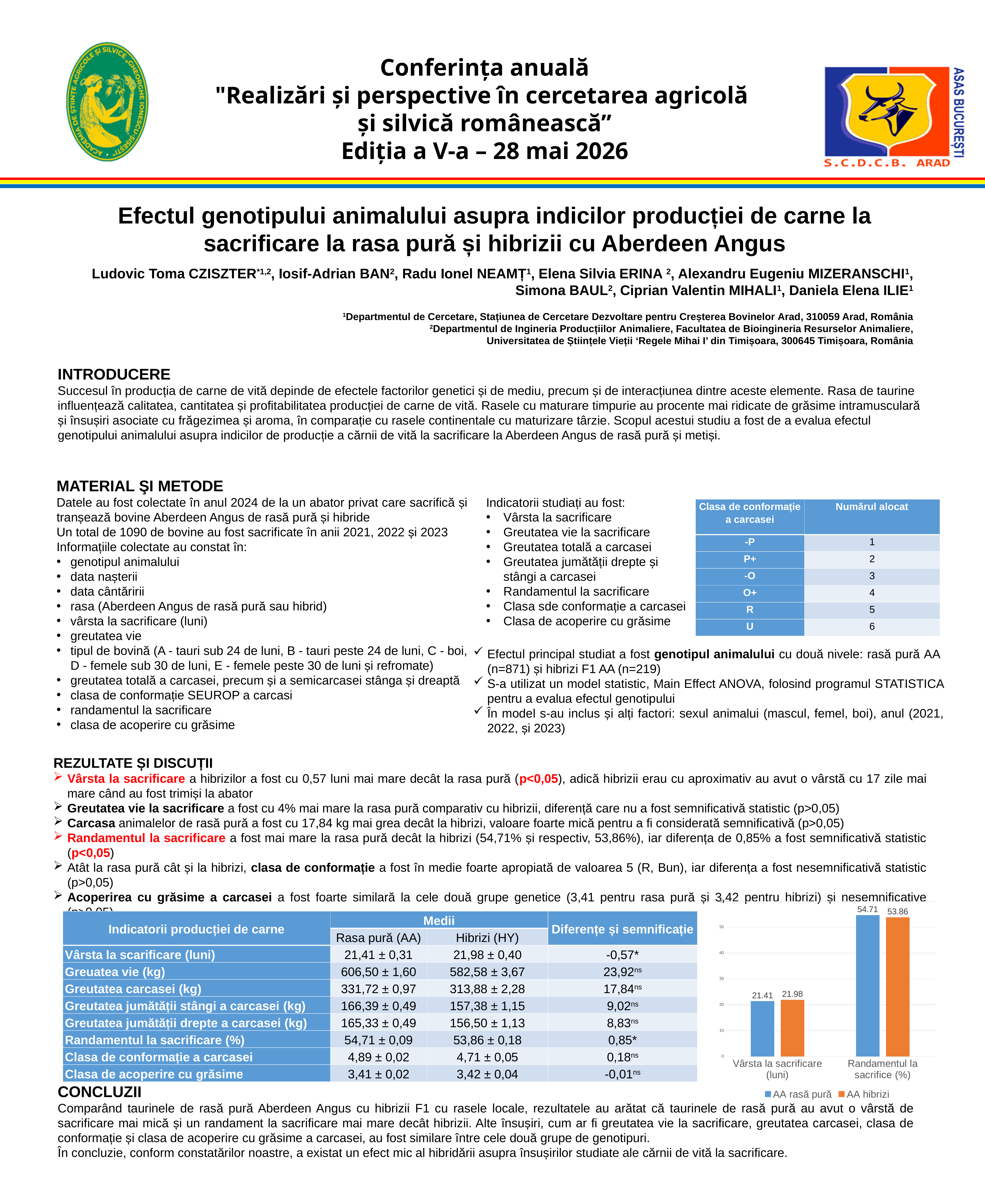
In the bar chart, which series has the higher value for Randamentul la sacrifice (%)? AA rasă pură In the bar chart, what is the value for AA rasă pură for Vârsta la sacrificare (luni)? 21.41 In the bar chart, is the AA rasă pură value for Randamentul la sacrifice (%) greater or less than 50? greater In the bar chart, what is the difference between the AA rasă pură and AA hibrizi values for Randamentul la sacrifice (%)? 0.85 In the bar chart, what is the value for AA hibrizi for Vârsta la sacrificare (luni)? 21.98 In the bar chart, what is the difference between the AA hibrizi and AA rasă pură values for Vârsta la sacrificare (luni)? 0.57 What kind of chart is shown at the bottom right of the slide? bar chart In the bar chart, how many series does the legend list? 2 In the bar chart, how many categories are shown on the x axis? 2 In the bar chart, which series is shown in orange? AA hibrizi In the bar chart, what is the value for AA rasă pură for Randamentul la sacrifice (%)? 54.71 In the bar chart, what is the value for AA hibrizi for Randamentul la sacrifice (%)? 53.86